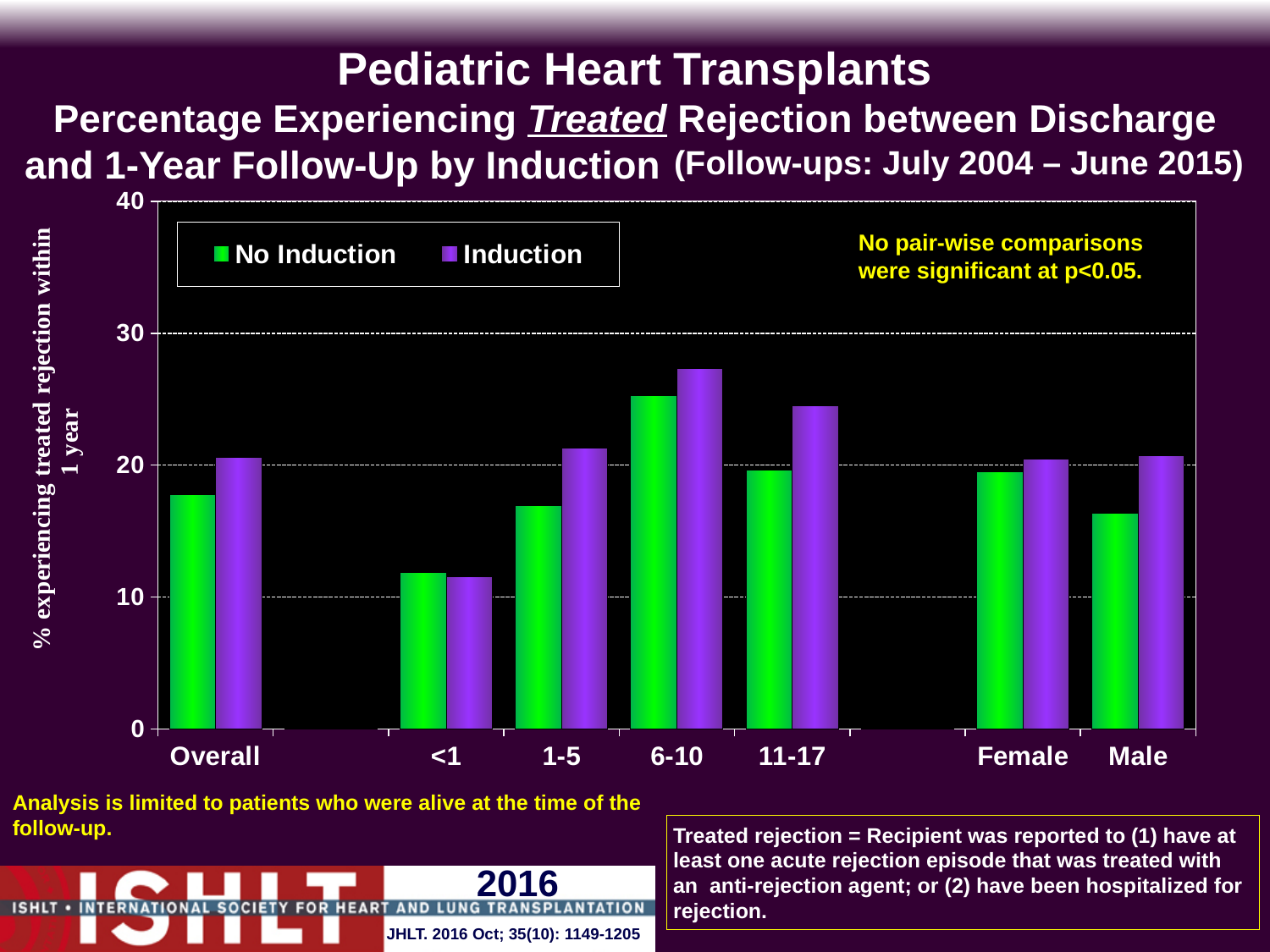
How many series does the legend list? 2 Which colour represents the No Induction series in the legend? green For the 11-17 age group, which is larger: the No Induction value or the Induction value? Induction Is the Induction value for <1 greater or less than 10? greater Which category has the highest value for the Induction series? 6-10 Is the No Induction value for Overall greater or less than 20? less Is the Induction value for 6-10 greater or less than 20? greater What kind of chart is shown on the slide? bar chart For Male, which is larger: the No Induction value or the Induction value? Induction Which category has the highest value for the No Induction series? 6-10 How many categories are shown along the x axis? 7 Which category has the lowest value for the Induction series? <1